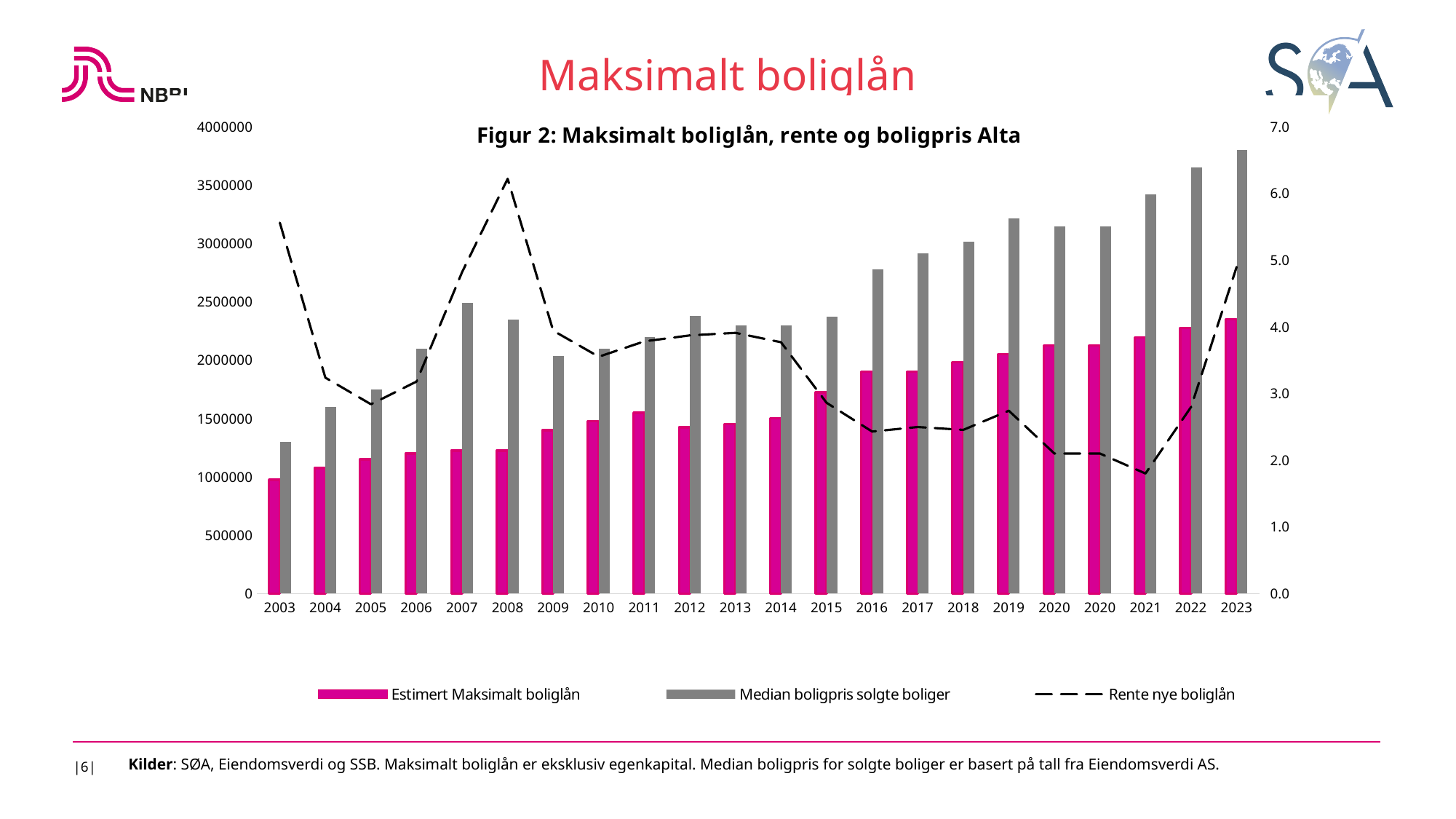
How many year labels are shown on the x axis? 22 Is the Median boligpris solgte boliger value for 2023 greater or less than 3500000? greater What kind of chart is shown on the slide? A combined bar and line chart In which year is the Median boligpris solgte boliger bar highest? 2023 In which year does the Rente nye boliglån line reach its highest point? 2008 Does the Estimert Maksimalt boliglån series generally rise or fall from 2003 to 2023? Rise What is the title of the figure? Figur 2: Maksimalt boliglån, rente og boligpris Alta In which year does the Rente nye boliglån line reach its lowest point? 2021 How many series does the legend list? 3 Is the Rente nye boliglån value for 2021 greater or less than 2.0? less In which year is the Estimert Maksimalt boliglån bar lowest? 2003 Which is larger, the Median boligpris solgte boliger bar for 2007 or for 2008? 2007